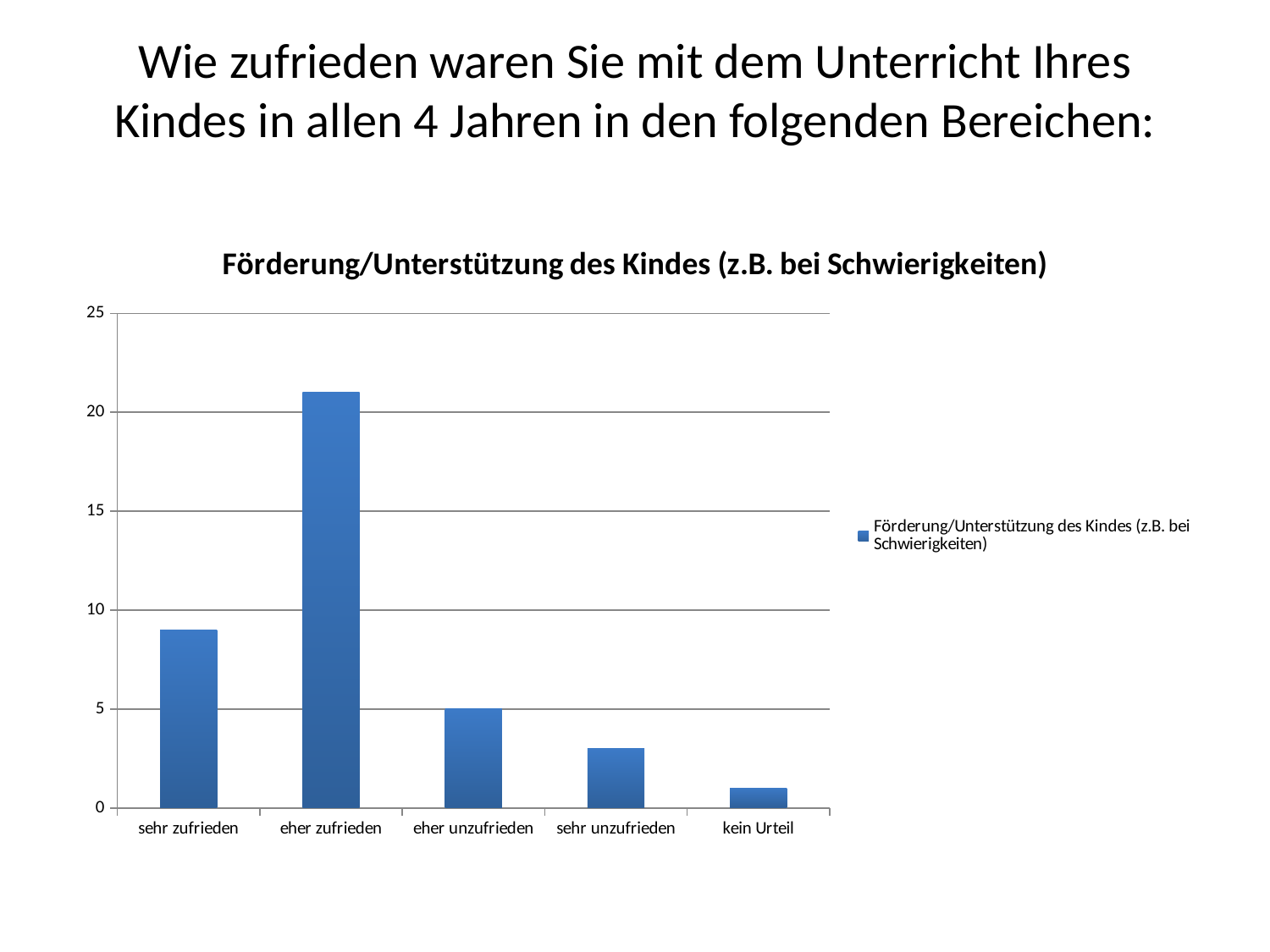
How many categories are shown on the x axis of the chart? 5 Do the values rise or fall from eher zufrieden to kein Urteil along the x axis? fall Which category has the lowest value? kein Urteil Which is larger, the value for sehr zufrieden or the value for eher unzufrieden? sehr zufrieden Is the value for sehr zufrieden greater or less than 10? less Which category has the highest value? eher zufrieden What is the value for eher unzufrieden? 5 What is the title of the chart? Förderung/Unterstützung des Kindes (z.B. bei Schwierigkeiten) Is the value for sehr unzufrieden greater or less than 5? less Is the value for eher zufrieden greater or less than 20? greater How many series does the legend list? 1 What kind of chart is shown on the slide? bar chart